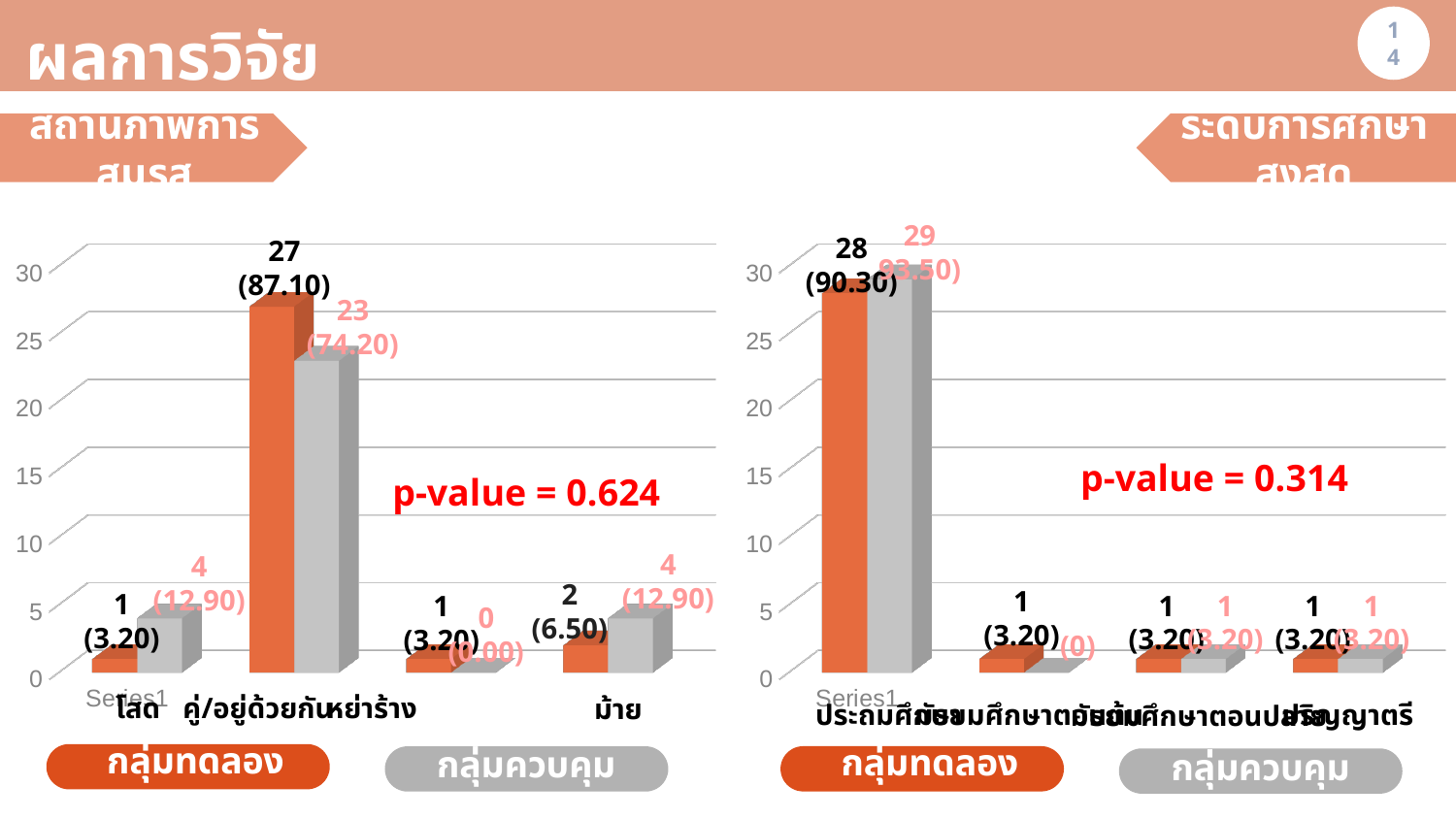
In the left chart (สถานภาพการสมรส), what is the value for กลุ่มควบคุม in the โสด category? 4 (12.90) In the left chart (สถานภาพการสมรส), what is the value for กลุ่มทดลอง in the คู่/อยู่ด้วยกัน category? 27 (87.10) In the left chart (สถานภาพการสมรส), what is the value for กลุ่มควบคุม in the คู่/อยู่ด้วยกัน category? 23 (74.20) What p-value is shown on the left chart (สถานภาพการสมรส)? 0.624 In the left chart (สถานภาพการสมรส), how many categories are shown on the x axis? 4 What type of chart is used on the right side of the slide (ระดับการศึกษาสูงสุด)? bar chart In the left chart (สถานภาพการสมรส), what is the difference between the กลุ่มทดลอง and กลุ่มควบคุม counts for คู่/อยู่ด้วยกัน? 4 In the right chart (ระดับการศึกษาสูงสุด), is the value for กลุ่มควบคุม in ประถมศึกษา greater or less than 25? greater In the left chart (สถานภาพการสมรส), which group has the larger count for ม้าย, กลุ่มทดลอง or กลุ่มควบคุม? กลุ่มควบคุม In the left chart (สถานภาพการสมรส), which category has the highest value for กลุ่มทดลอง? คู่/อยู่ด้วยกัน In the right chart (ระดับการศึกษาสูงสุด), what is the value for กลุ่มทดลอง in the ประถมศึกษา category? 28 (90.30) In the right chart (ระดับการศึกษาสูงสุด), what is the value for กลุ่มควบคุม in the ประถมศึกษา category? 29 (93.50)